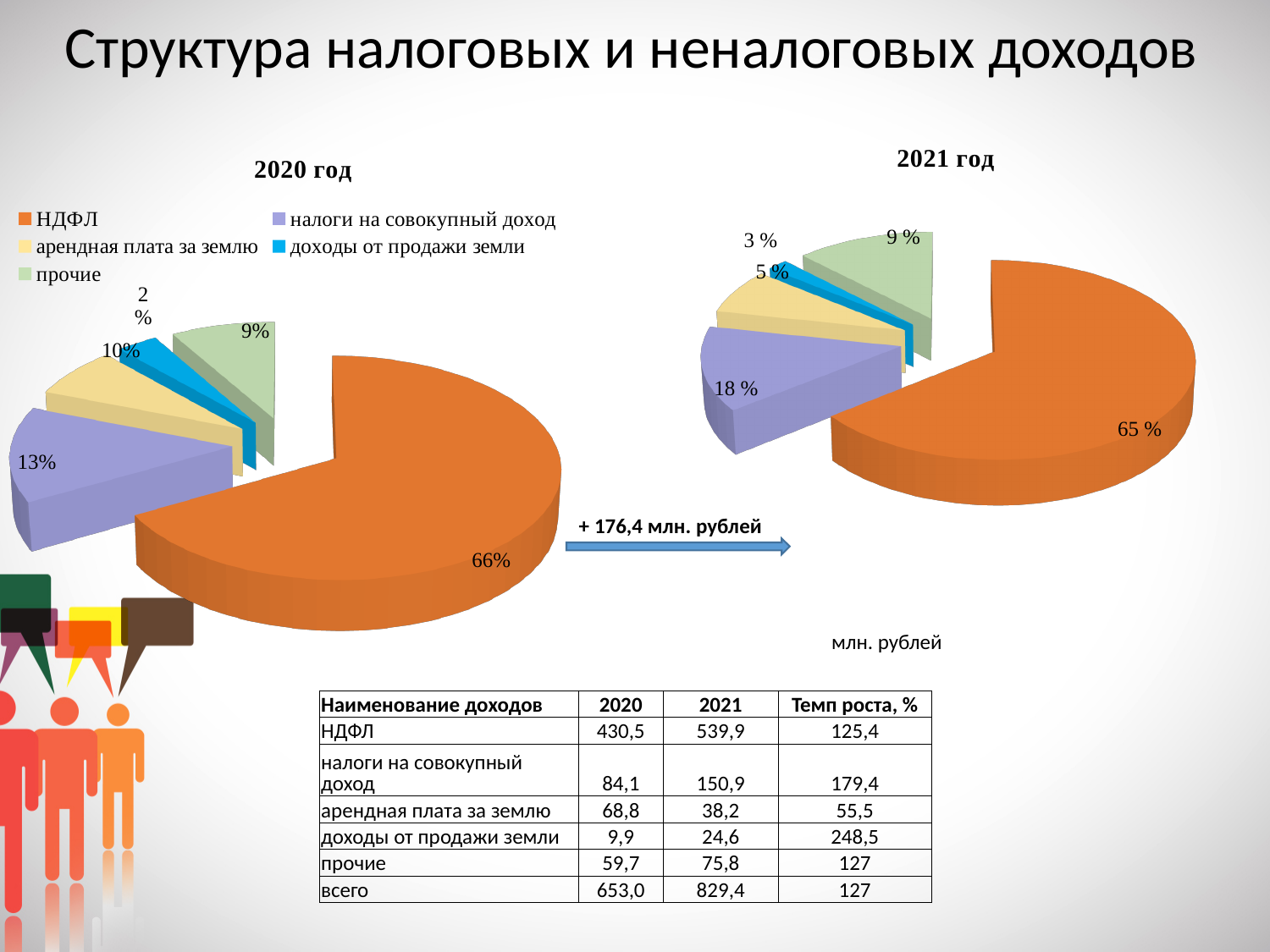
In the 2021 год pie chart, which category has the smallest slice? доходы от продажи земли In the 2020 год pie chart, what share does налоги на совокупный доход have? 13% In the 2021 год pie chart, what share does арендная плата за землю have? 5 % In the 2020 год pie chart, what share does НДФЛ have? 66% In the 2020 год pie chart, what is the difference between the share of арендная плата за землю and the share of прочие? 1% How many categories does the legend of the 2020 год chart list? 5 In the 2021 год pie chart, which is larger: the share of прочие or the share of арендная плата за землю? прочие What type of chart is used for the 2020 год chart? pie chart In the 2020 год pie chart, which category has the largest slice? НДФЛ In the 2020 год pie chart, which category has the smallest slice? доходы от продажи земли